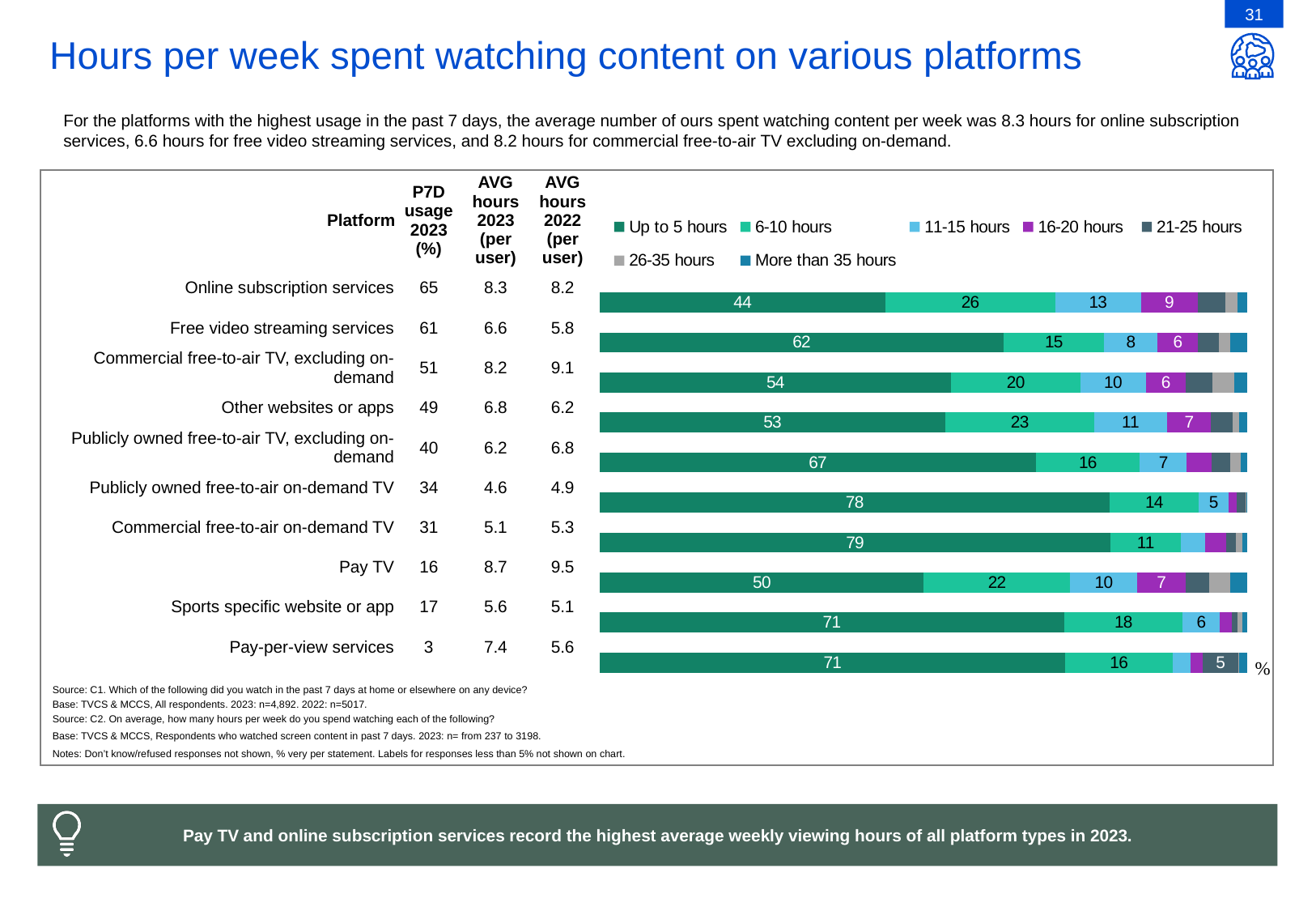
What is the value for the 11-15 hours segment for Commercial free-to-air TV, excluding on-demand? 10 What is the value for the 16-20 hours segment for Online subscription services? 9 How many series does the chart legend list? 7 For Online subscription services, what is the difference between the 6-10 hours value and the 11-15 hours value? 13 How many platforms are plotted in the chart? 10 What is the first entry in the chart legend? Up to 5 hours Which has a larger 6-10 hours value: Online subscription services or Free video streaming services? Online subscription services What percentage of Online subscription services users watch Up to 5 hours per week? 44 Which platform has the lowest value for the Up to 5 hours segment? Online subscription services What type of chart is shown on the slide? Stacked bar chart What is the value for the 6-10 hours segment for Pay TV? 22 Which platform has the highest value for the Up to 5 hours segment? Commercial free-to-air on-demand TV